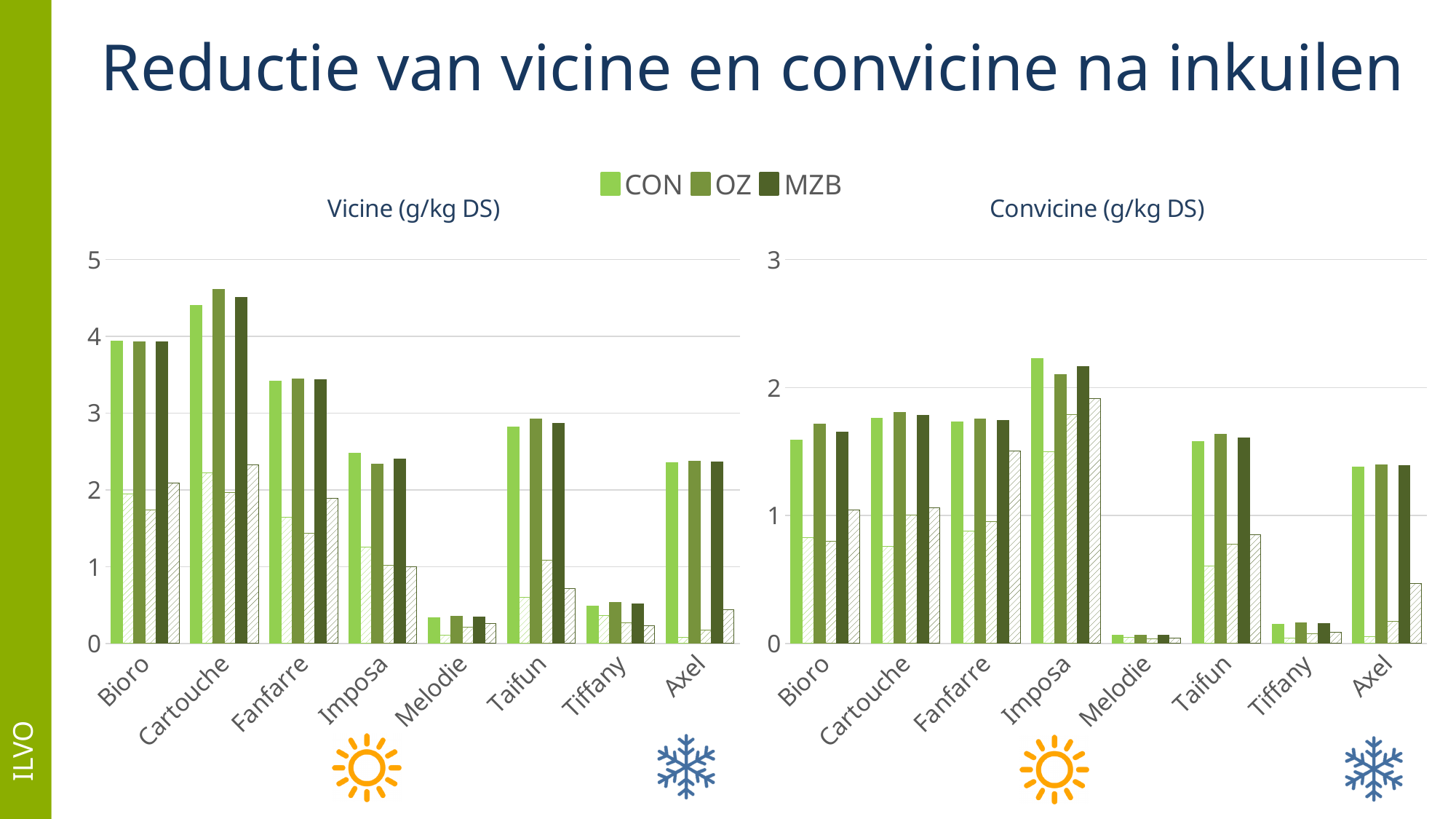
In the Convicine (g/kg DS) chart, which category has the lowest bars? Melodie In the Convicine (g/kg DS) chart, which is larger, the solid CON bar for Imposa or the solid CON bar for Tiffany? Imposa What are the series names in the legend? CON, OZ, MZB In the Vicine (g/kg DS) chart, is the solid CON bar for Tiffany greater or less than 1? less In the Convicine (g/kg DS) chart, which category has the highest bars? Imposa In the Vicine (g/kg DS) chart, is the solid OZ bar for Cartouche greater or less than 4? greater How many categories are shown on the x axis of the Convicine (g/kg DS) chart? 8 How many series does the legend list? 3 In the Vicine (g/kg DS) chart, which category has the highest bars? Cartouche What kind of chart is the Vicine (g/kg DS) chart? bar chart In the Convicine (g/kg DS) chart, is the solid CON bar for Imposa greater or less than 2? greater In the Vicine (g/kg DS) chart, which category has the lowest bars? Melodie